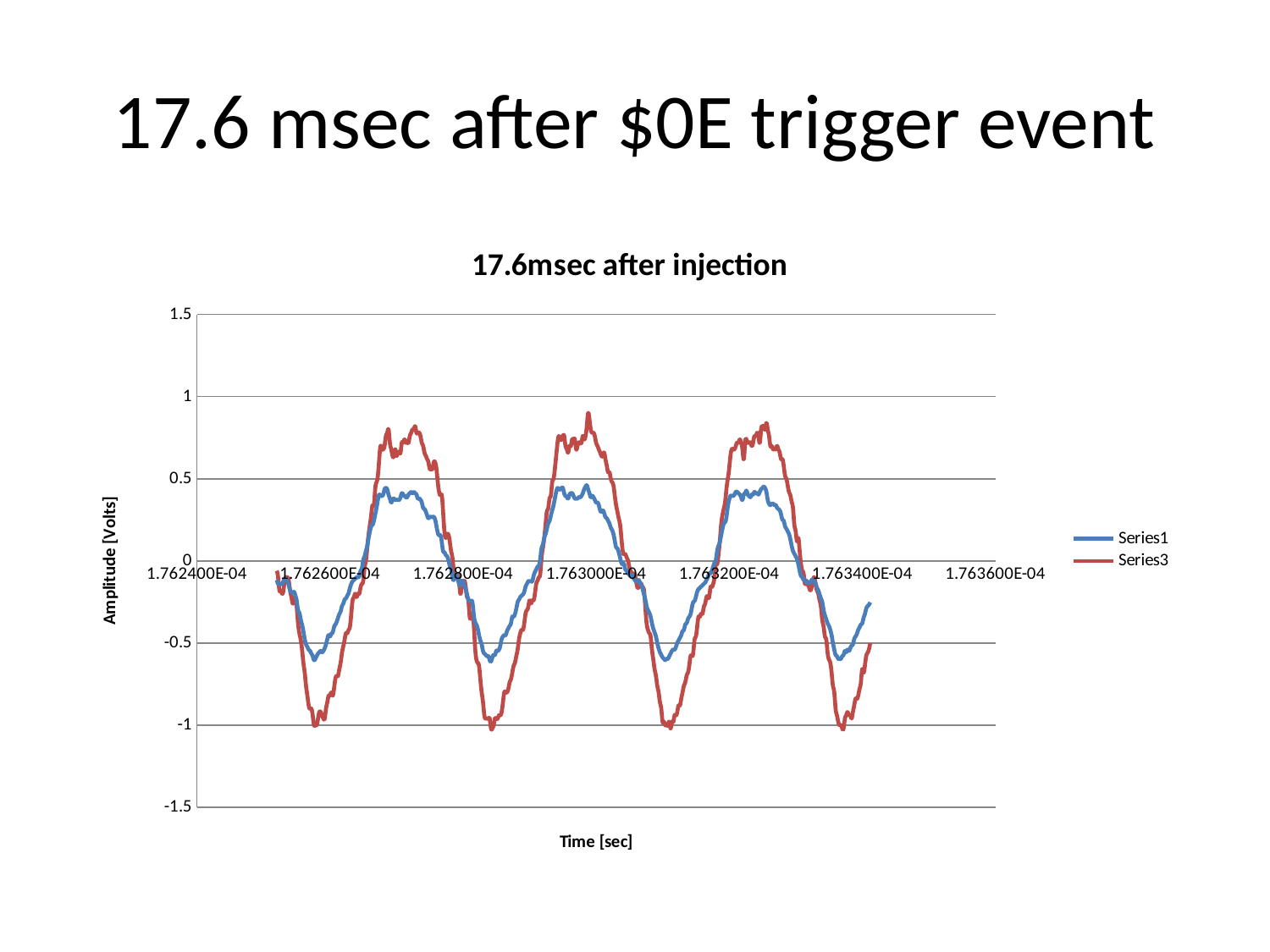
Is the highest value reached by Series1 greater or less than 0.5? less How many positive peaks does Series3 show across the plotted time range? 3 Which series reaches the higher peak amplitude, Series1 or Series3? Series3 What kind of chart is shown on the slide? line chart Is the highest value reached by Series1 greater or less than 0? greater How many series does the legend list? 2 Which series reaches the lower minimum amplitude, Series1 or Series3? Series3 What is the title of the chart? 17.6msec after injection What is the label of the vertical axis? Amplitude [Volts] Is the lowest value reached by Series1 greater or less than -1? greater